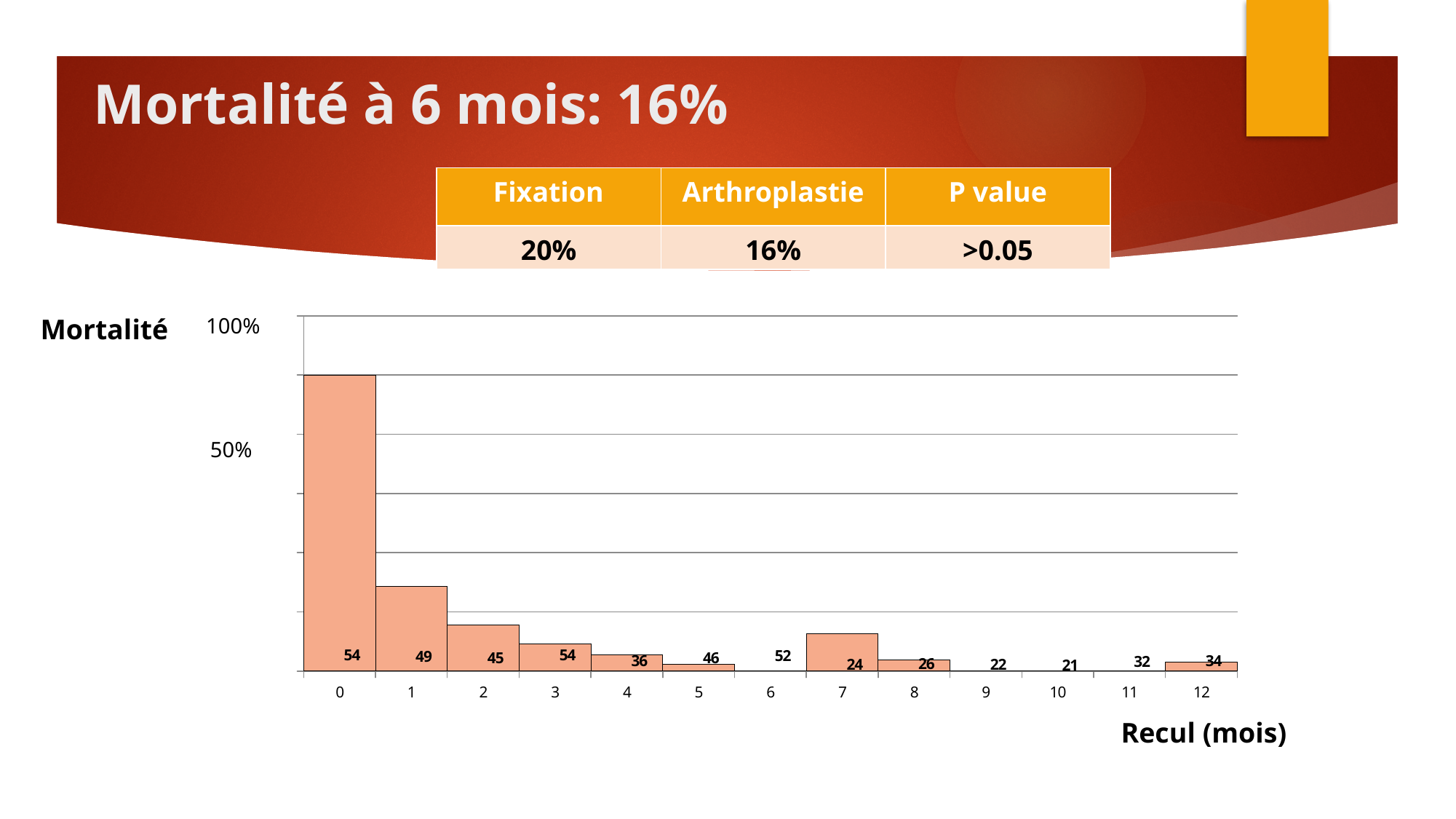
Which bar is taller, the one for month 1 or the one for month 7? month 1 Which month on the x axis has the tallest bar? 0 Which bar is taller, the one for month 7 or the one for month 8? month 7 How many months (categories) are shown along the x axis of the chart? 13 Do the bar heights generally rise or fall as the months increase along the x axis? fall What data label is printed for month 7? 24 What is the label of the x axis of the chart? Recul (mois) What kind of chart is shown on the slide? bar chart Is the mortality bar for month 0 greater or less than 50%? greater What data label is printed on the bar for month 0? 54 What is the label of the y axis of the chart? Mortalité Is the mortality bar for month 1 greater or less than 50%? less